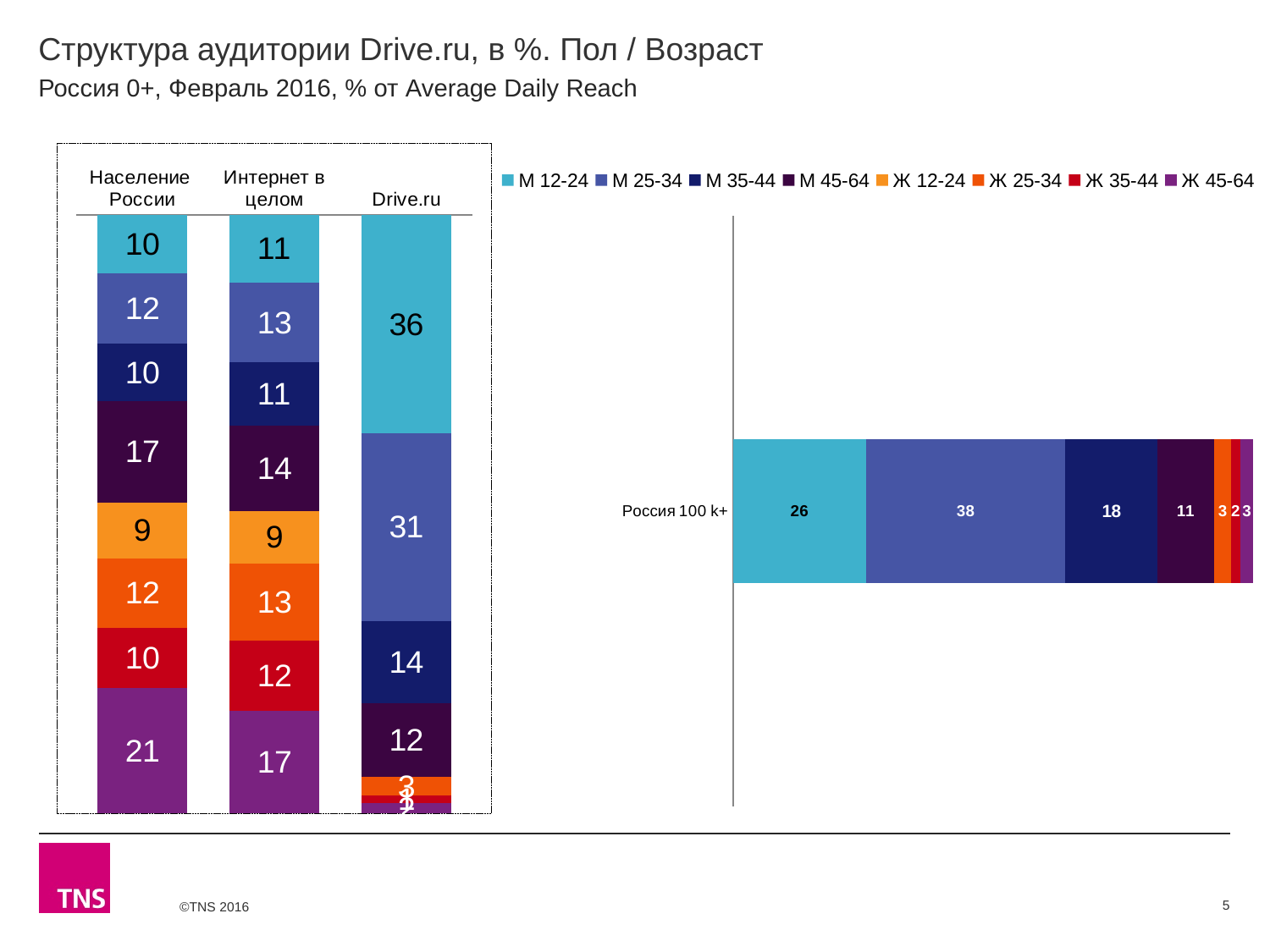
In the right chart (Россия 100 k+), what is the value of the М 35-44 segment? 18 In the left chart, what is the value of the Ж 45-64 segment for Население России? 21 In the left chart, what is the difference between the М 12-24 value for Drive.ru and the М 12-24 value for Население России? 26 In the right chart (Россия 100 k+), which segment has the highest value? М 25-34 In the right chart (Россия 100 k+), what is the value of the М 25-34 segment? 38 In the left chart, which segment is the largest in the Drive.ru bar? М 12-24 How many series does the legend list? 8 In the left chart, which has the larger Ж 45-64 value: Население России or Интернет в целом? Население России In the left chart, what is the value of the М 45-64 segment for Интернет в целом? 14 In the left chart, what is the value of the М 12-24 segment for Drive.ru? 36 What kind of chart is the right chart (Россия 100 k+)? Stacked bar chart How many bars (categories) are shown in the left chart? 3